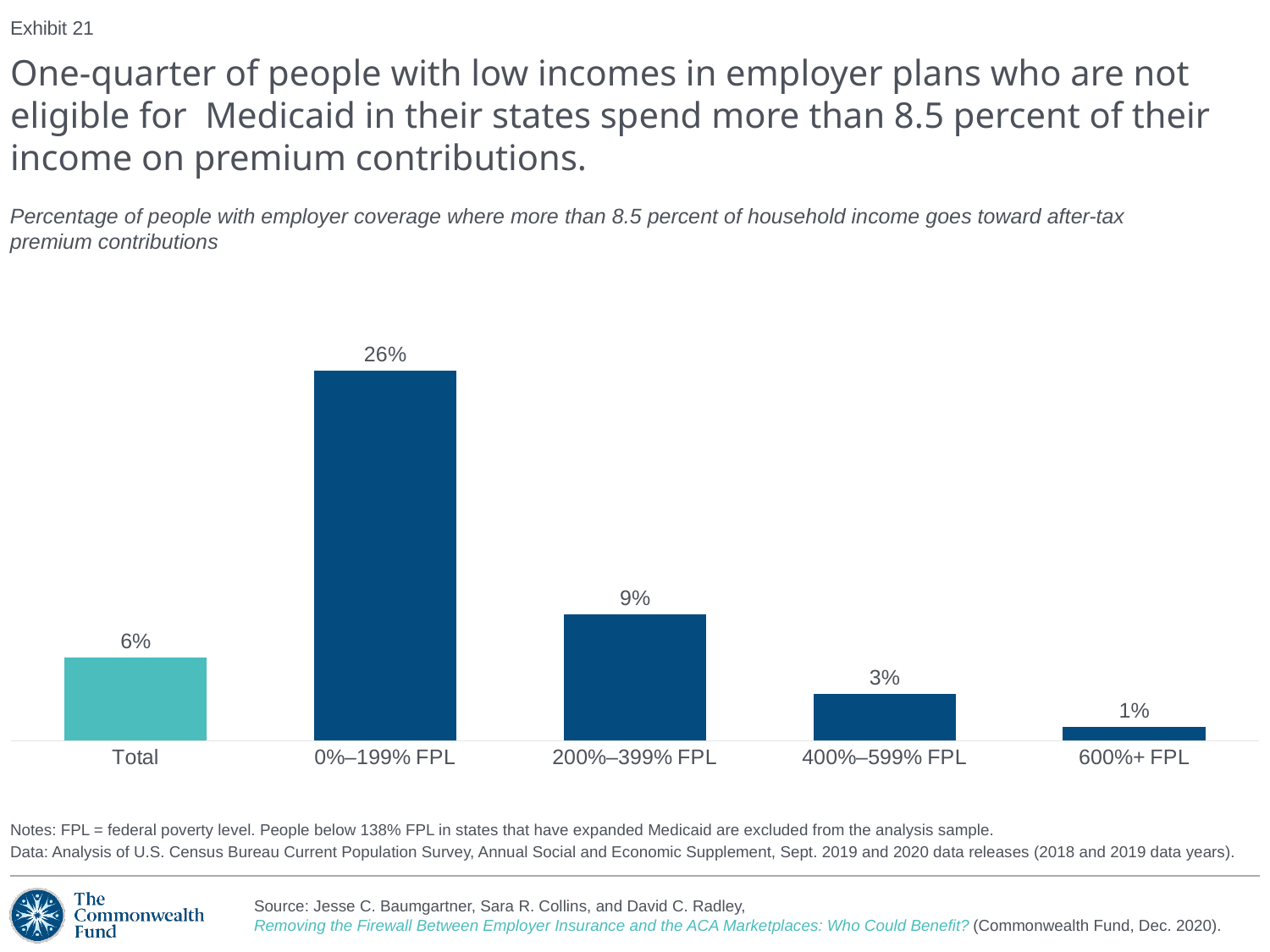
Do the values rise or fall across the FPL categories from 0%–199% FPL to 600%+ FPL? Fall How many categories are shown on the x axis? 5 Which category has the highest value? 0%–199% FPL Which category has the lowest value? 600%+ FPL What is the difference between the values for 0%–199% FPL and 200%–399% FPL? 17 percentage points What is the value for 600%+ FPL? 1% What kind of chart is shown on the slide? Bar chart What is the value for 0%–199% FPL? 26% What is the value for 200%–399% FPL? 9% What is the value for 400%–599% FPL? 3% Which is larger, the value for Total or the value for 200%–399% FPL? 200%–399% FPL What is the value for Total? 6%